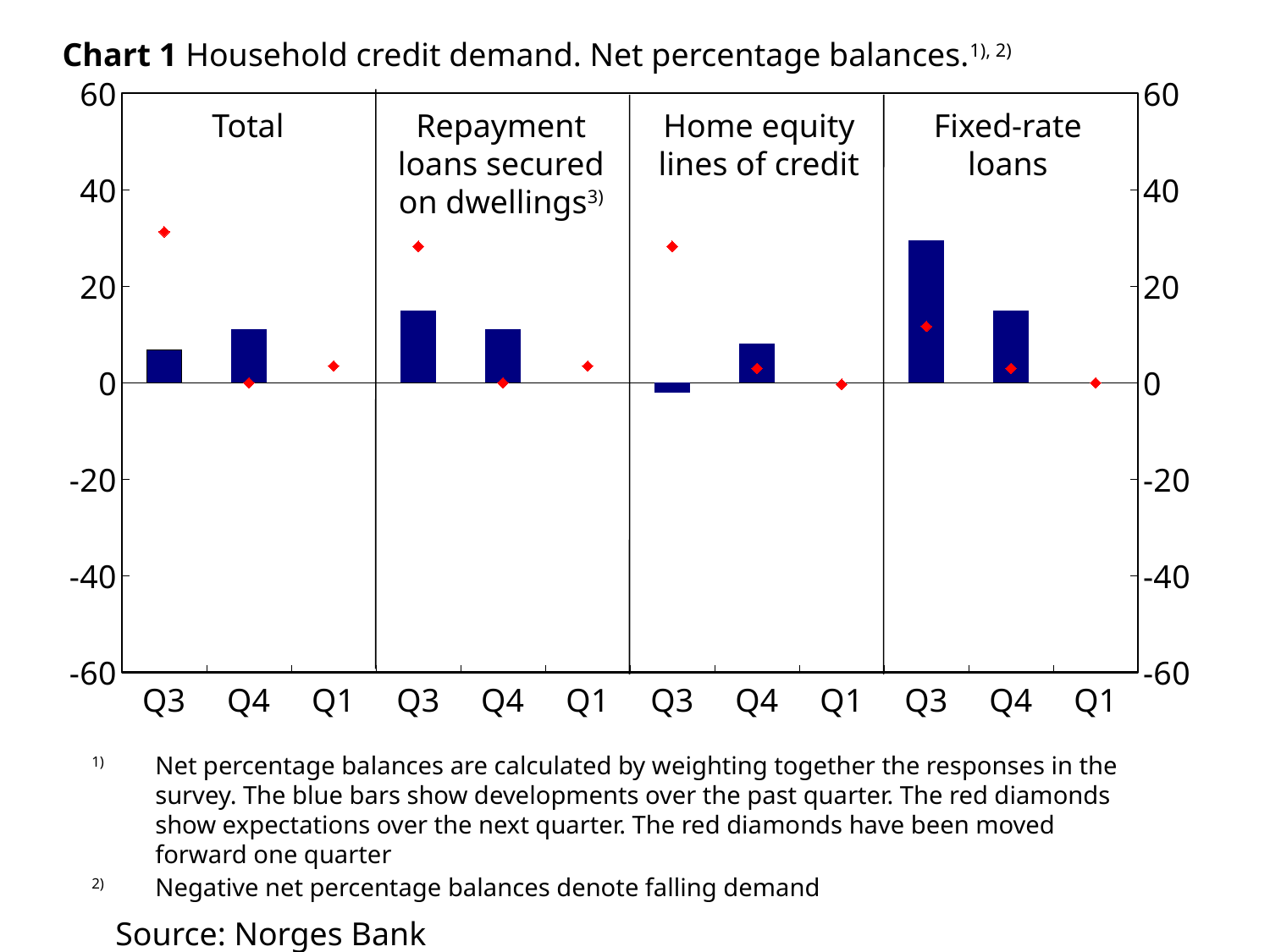
Which category has the highest Q3 blue bar? Fixed-rate loans For Fixed-rate loans, which blue bar is larger, Q3 or Q4? Q3 Do the blue bars for Fixed-rate loans rise or fall from Q3 to Q4? fall Do the blue bars for Home equity lines of credit rise or fall from Q3 to Q4? rise What is the source given for the chart? Norges Bank Is the Q3 red diamond for Total greater or less than 20? greater What kind of chart is Chart 1? combination chart (bars with red diamond markers) For Total, which blue bar is larger, Q3 or Q4? Q4 Is the Q3 blue bar for Fixed-rate loans greater or less than 20? greater Is the Q3 blue bar for Total greater or less than 20? less Which category has a negative blue bar? Home equity lines of credit How many loan categories (panels) are shown in the chart? 4